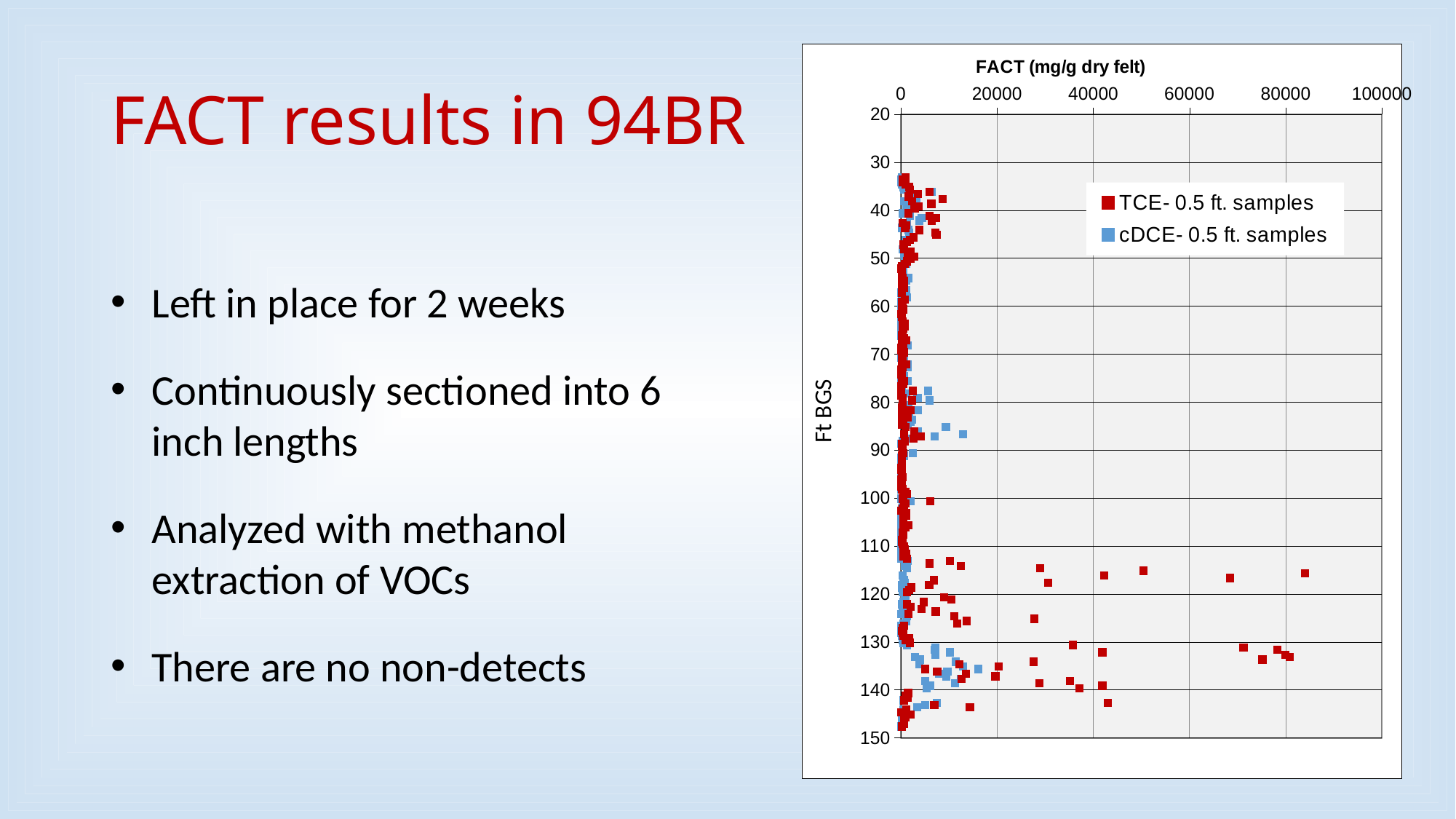
What kind of chart is shown on the slide? scatter chart What is the largest value shown on the chart's horizontal axis? 100000 Which series in the chart is plotted with red markers? TCE- 0.5 ft. samples What is the title of the chart's horizontal axis? FACT (mg/g dry felt) Is the highest TCE value plotted in the chart greater or less than 80000? greater Which series reaches the highest FACT value in the chart, TCE or cDCE? TCE- 0.5 ft. samples Which series has larger values at depths between 110 and 140 ft BGS, TCE or cDCE? TCE- 0.5 ft. samples Is the highest cDCE value plotted in the chart greater or less than 20000? less How many series does the chart legend list? 2